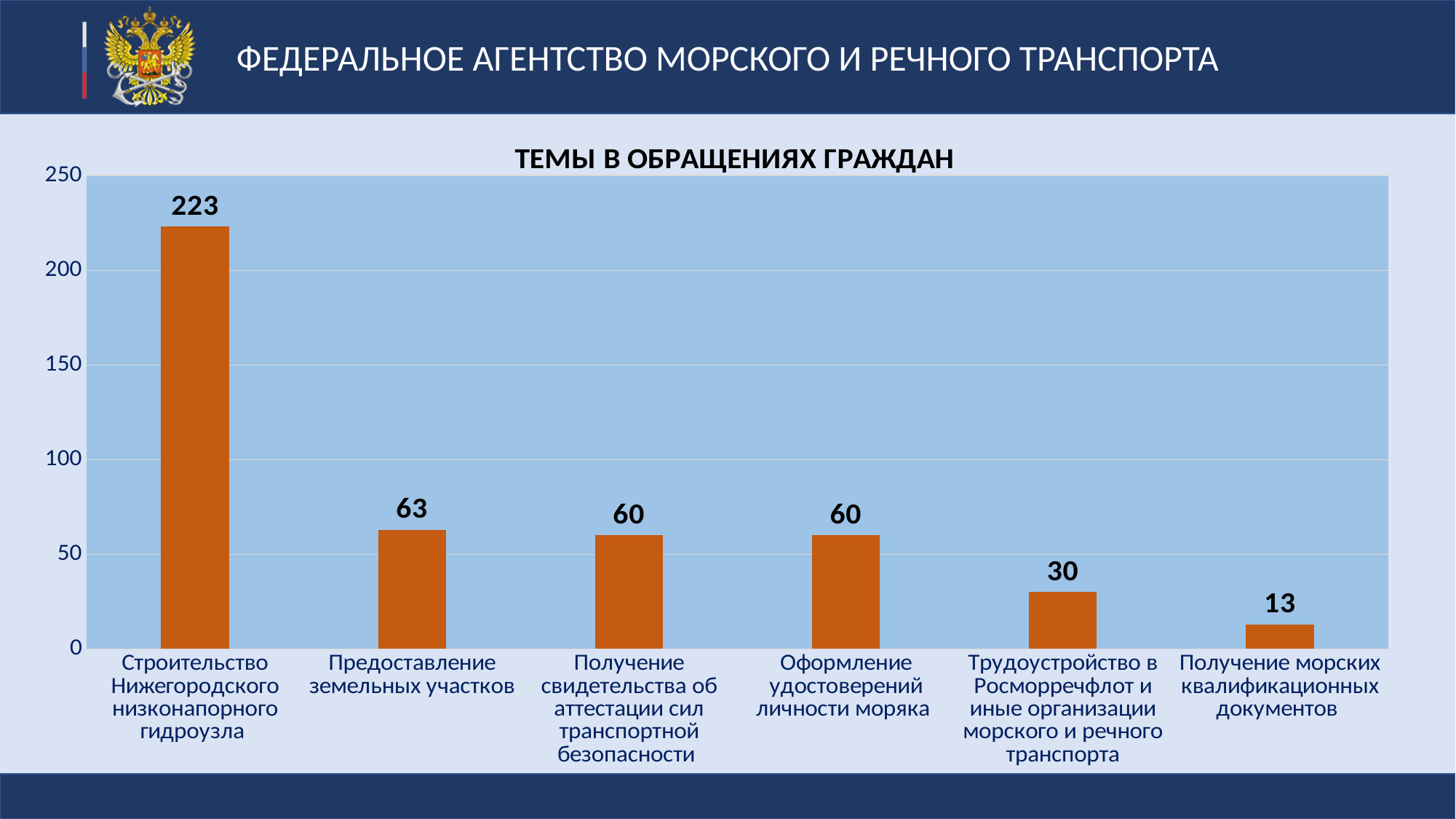
What is the value for Получение морских квалификационных документов? 13 What is the value for Предоставление земельных участков? 63 What is the value for Трудоустройство в Росморречфлот и иные организации морского и речного транспорта? 30 Which category has the lowest value? Получение морских квалификационных документов What is the difference between the values for Строительство Нижегородского низконапорного гидроузла and Предоставление земельных участков? 160 What kind of chart is shown on the slide? Bar chart Which is larger: the value for Предоставление земельных участков or the value for Оформление удостоверений личности моряка? Предоставление земельных участков What is the title of the chart? ТЕМЫ В ОБРАЩЕНИЯХ ГРАЖДАН Which category has the highest value? Строительство Нижегородского низконапорного гидроузла What is the value for Строительство Нижегородского низконапорного гидроузла? 223 What is the difference between the values for Трудоустройство в Росморречфлот и иные организации морского и речного транспорта and Получение морских квалификационных документов? 17 How many categories are shown in the chart? 6